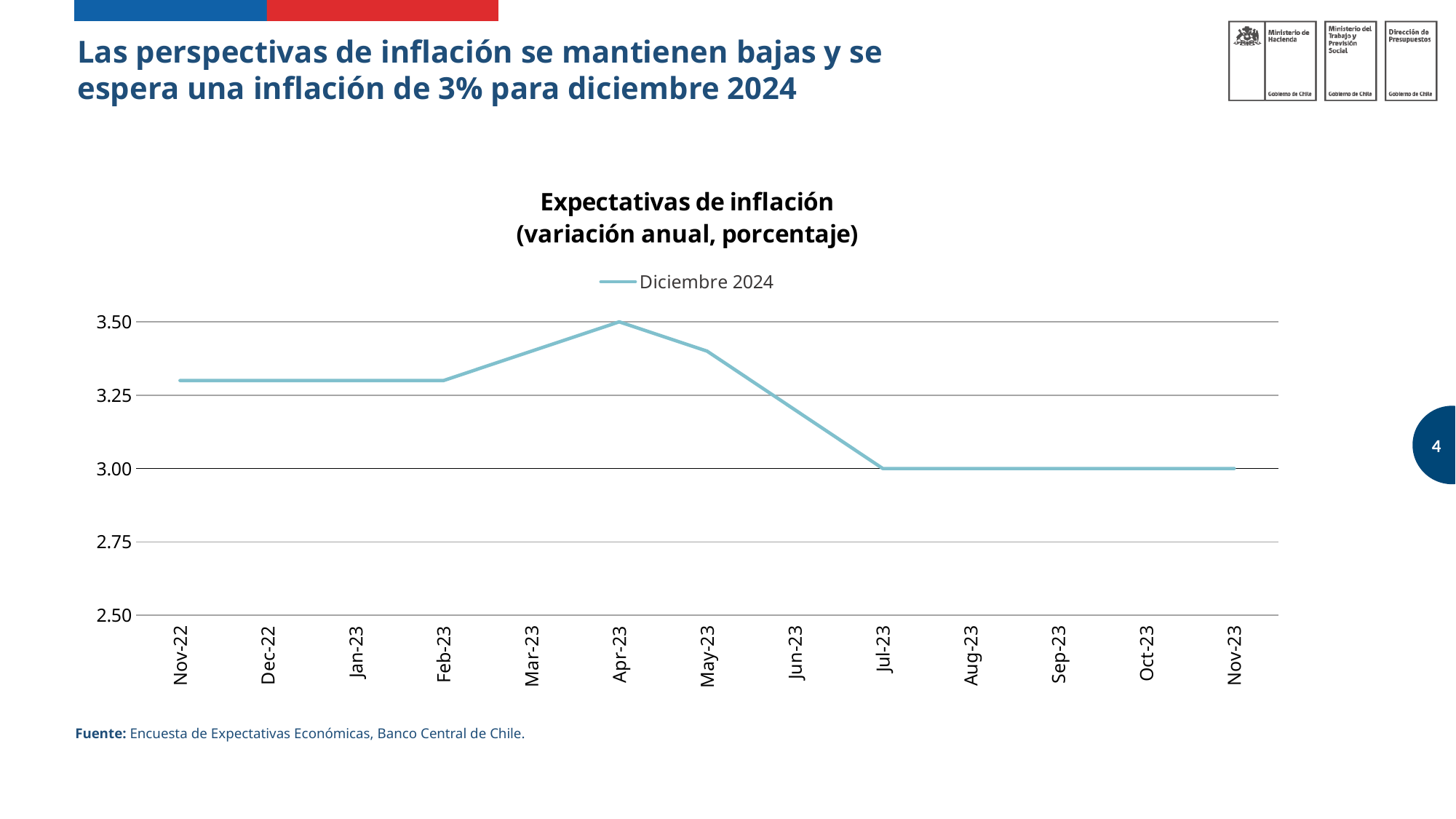
What is the name of the series shown in the legend? Diciembre 2024 What is the inflation expectation value for Nov-23? 3.00 What is the difference between the value for Apr-23 and the value for Nov-23? 0.50 How many months are plotted along the x axis? 13 What is the inflation expectation value for Aug-23? 3.00 In which month does the inflation expectation reach its highest value? Apr-23 Which is larger, the value for Apr-23 or the value for Jul-23? Apr-23 How many series does the legend list? 1 What kind of chart is shown on the slide? line chart What is the inflation expectation value for Apr-23? 3.50 Is the value for Nov-22 greater or less than 3.25? greater Is the value for Jun-23 greater or less than 3.25? less